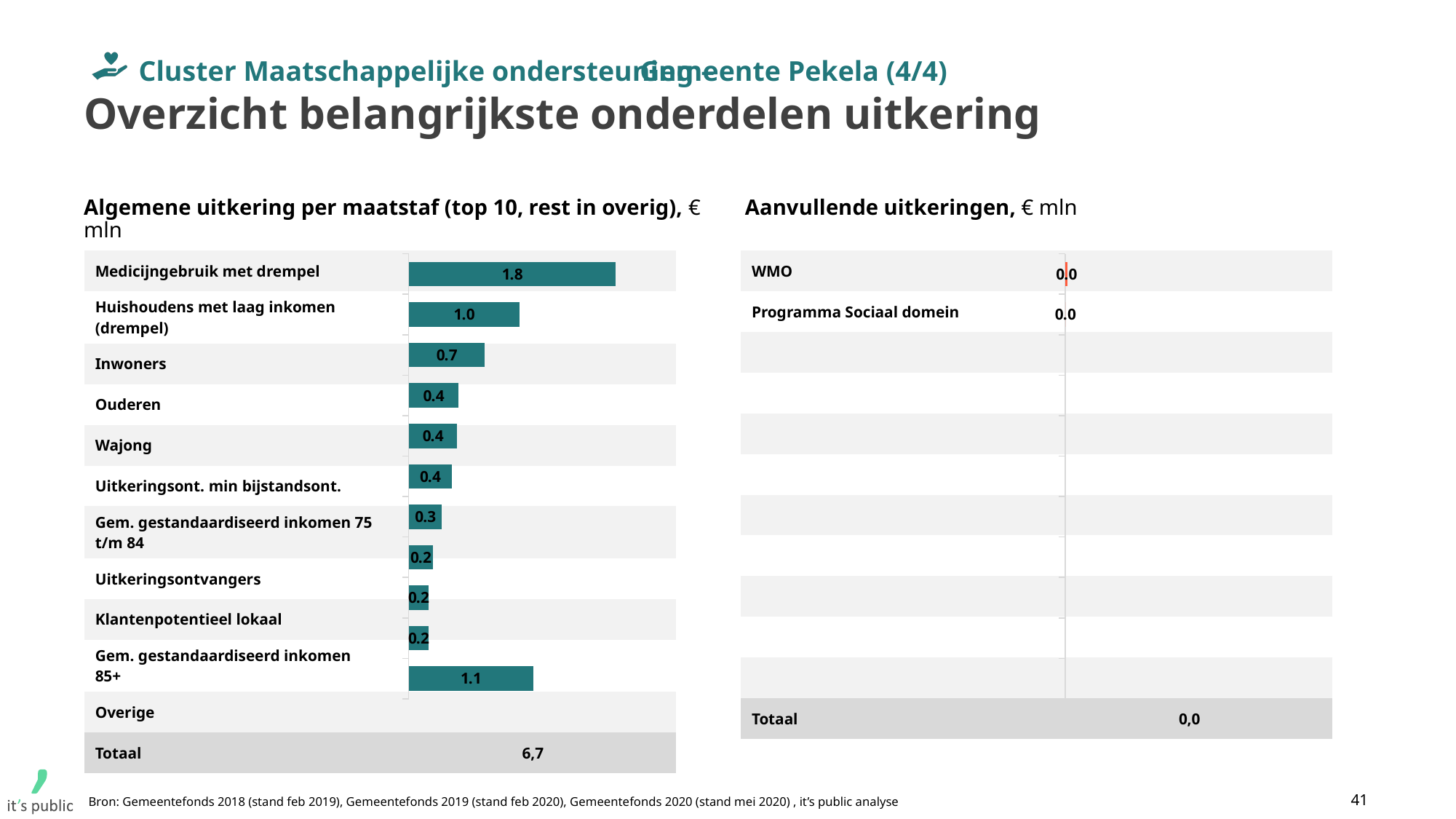
In the chart 'Algemene uitkering per maatstaf', how many categories are shown (excluding the Totaal row)? 11 In the chart 'Algemene uitkering per maatstaf', what is the difference between Medicijngebruik met drempel and Huishoudens met laag inkomen (drempel)? 0.8 In the chart 'Algemene uitkering per maatstaf', what is the value for Overige? 1.1 In what unit are the values in the chart 'Aanvullende uitkeringen' expressed? € mln What kind of chart is 'Algemene uitkering per maatstaf'? Bar chart In the chart 'Algemene uitkering per maatstaf', what is the value for Inwoners? 0.7 In the chart 'Algemene uitkering per maatstaf', which is larger: Inwoners or Ouderen? Inwoners In the chart 'Algemene uitkering per maatstaf', what is the Totaal value? 6,7 In the chart 'Aanvullende uitkeringen', what is the value for WMO? 0.0 In the chart 'Aanvullende uitkeringen', what is the Totaal value? 0,0 In the chart 'Algemene uitkering per maatstaf', which category has the highest value? Medicijngebruik met drempel In the chart 'Algemene uitkering per maatstaf', what is the value for Medicijngebruik met drempel? 1.8